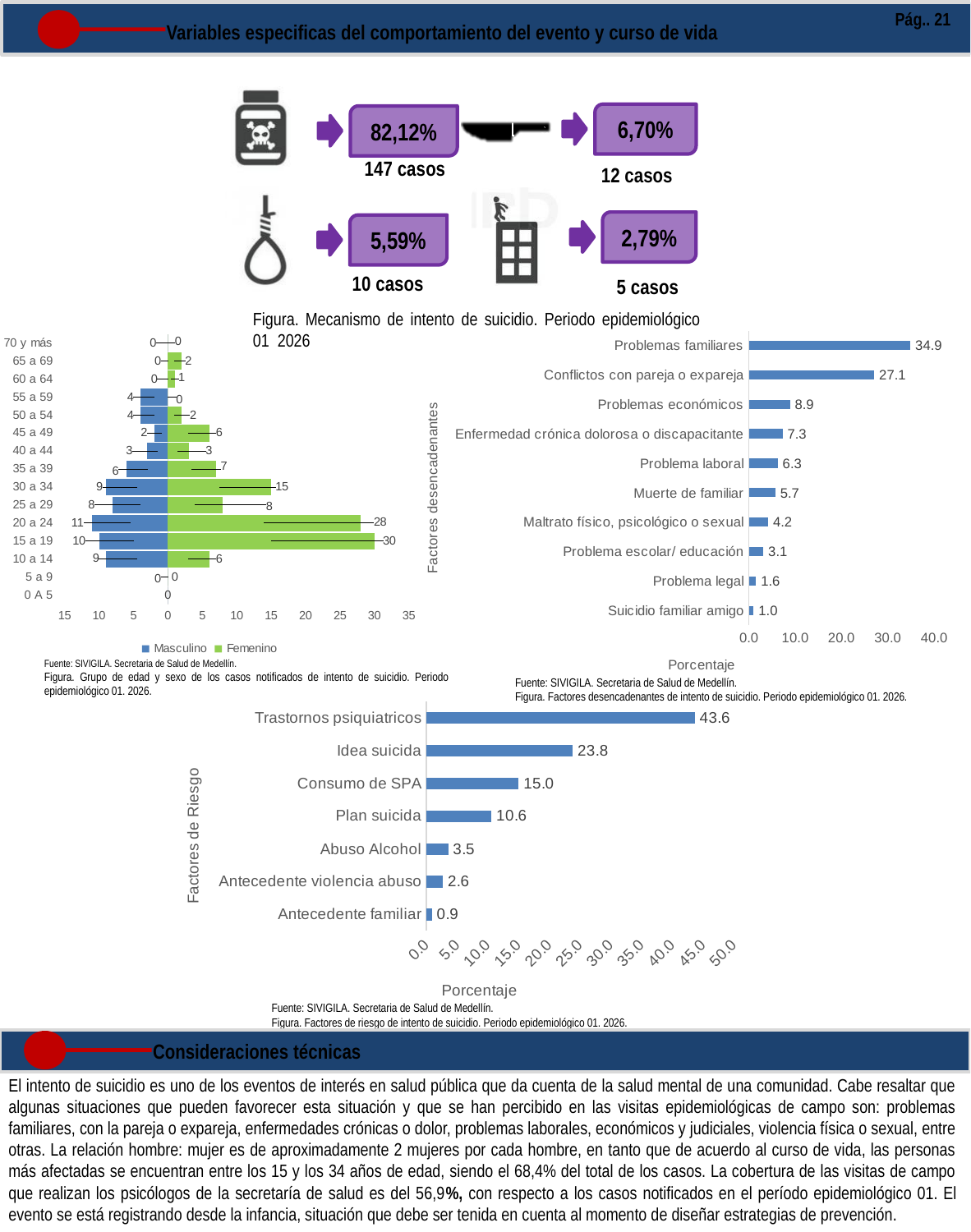
In the 'Factores de Riesgo' chart, how many risk factors are shown? 7 What kind of chart is the 'Factores de Riesgo' chart? Bar chart In the 'Factores desencadenantes' chart, which factor has the lowest value? Suicidio familiar amigo In the 'Factores de Riesgo' chart, what is the value for Trastornos psiquiatricos? 43.6 In the age group and sex chart, what is the difference between the Femenino and Masculino values for the 20 a 24 age group? 17 In the age group and sex chart, how many series does the legend list? 2 In the 'Factores desencadenantes' chart, what is the value for Problemas familiares? 34.9 In the 'Factores de Riesgo' chart, which is larger, Consumo de SPA or Plan suicida? Consumo de SPA In the age group and sex chart, what is the Masculino value for the 20 a 24 age group? 11 In the 'Factores desencadenantes' chart, what is the difference between Problemas familiares and Conflictos con pareja o expareja? 7.8 In the 'Factores desencadenantes' chart, how many factors are listed? 10 In the age group and sex chart, what is the Femenino value for the 15 a 19 age group? 30